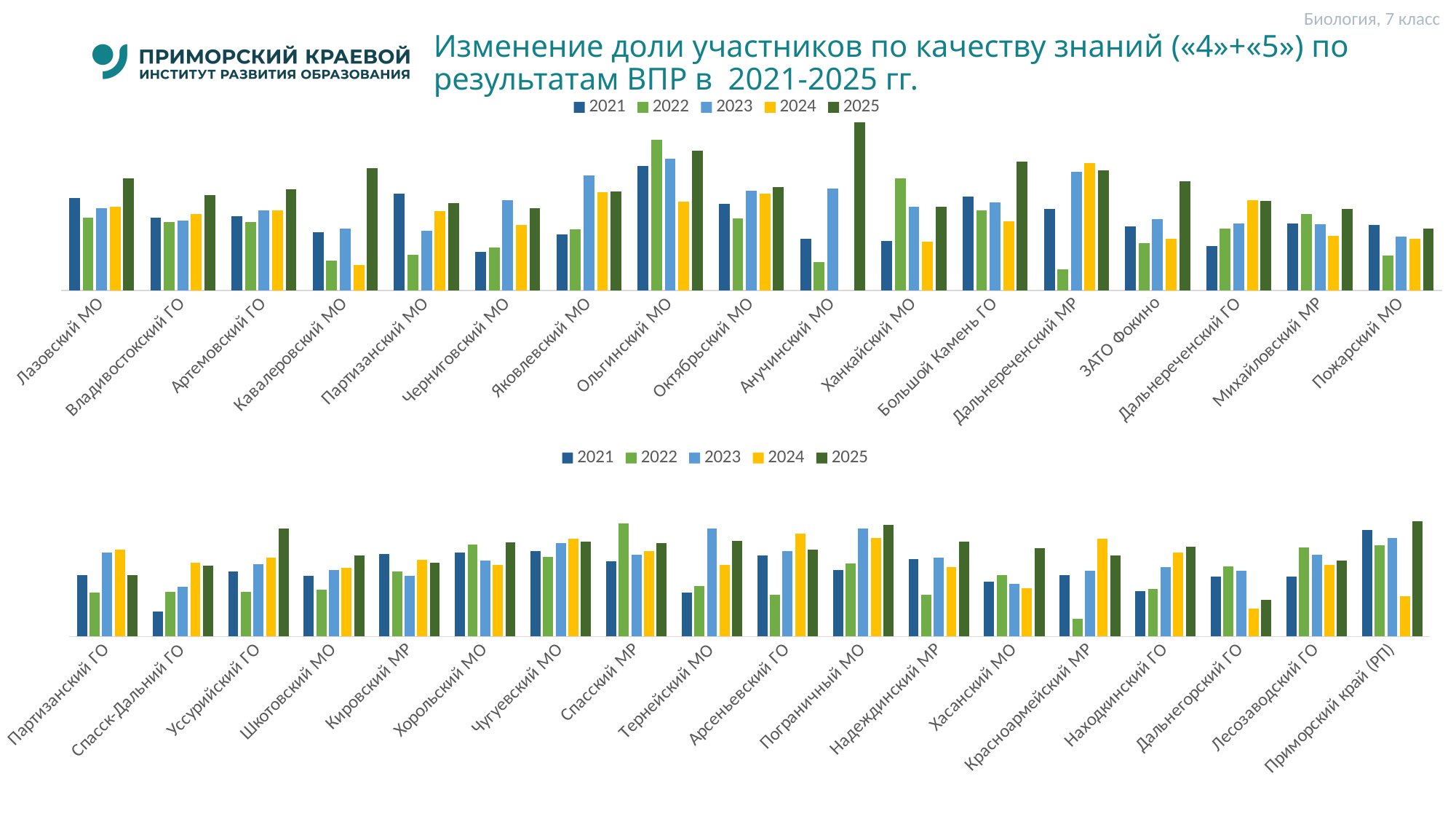
In the top chart, which year has the lowest bar for Дальнереченский МР? 2022 How many categories (municipalities) are shown on the x axis of the top chart? 17 In the top chart, which year has the highest bar for Анучинский МО? 2025 In the bottom chart, which year has the lowest bar for Спасск-Дальний ГО? 2021 What kind of chart is the top chart on the slide? bar chart In the top chart, is the 2025 value for Кавалеровский МО larger or smaller than its 2024 value? larger In the top chart, which year has the highest bar for Ханкайский МО? 2022 Which years are listed in the legend of the bottom chart? 2021, 2022, 2023, 2024, 2025 How many series does the legend of the top chart list? 5 How many categories are shown on the x axis of the bottom chart? 18 In the bottom chart, which year has the lowest bar for Красноармейский МР? 2022 In the bottom chart, do the values for Спасск-Дальний ГО rise or fall from 2021 to 2024? rise